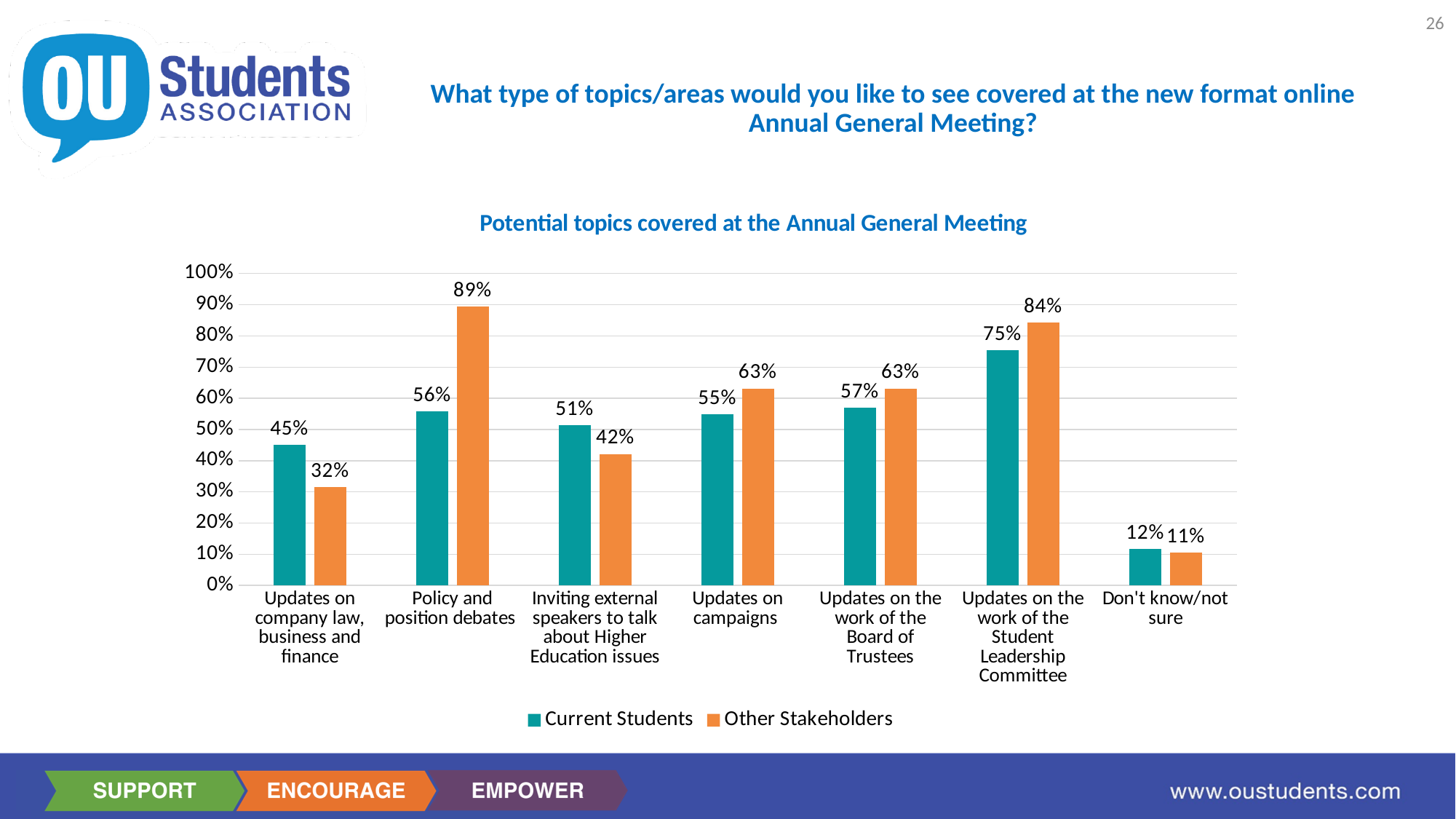
Which topic has the lowest value for Current Students? Don't know/not sure Is the Current Students value for Updates on the work of the Student Leadership Committee greater or less than 70%? greater Which topic has the highest value for Other Stakeholders? Policy and position debates What is the title of the chart? Potential topics covered at the Annual General Meeting What percentage of Other Stakeholders wanted Updates on the work of the Student Leadership Committee? 84% For Updates on company law, business and finance, which series has the larger value: Current Students or Other Stakeholders? Current Students How many series does the legend list? 2 How many topic categories are shown on the x axis? 7 What is the Other Stakeholders value for Inviting external speakers to talk about Higher Education issues? 42% What percentage of Current Students wanted Policy and position debates covered? 56% What is the difference between Other Stakeholders and Current Students for Policy and position debates? 33% What kind of chart is shown on the slide? Bar chart